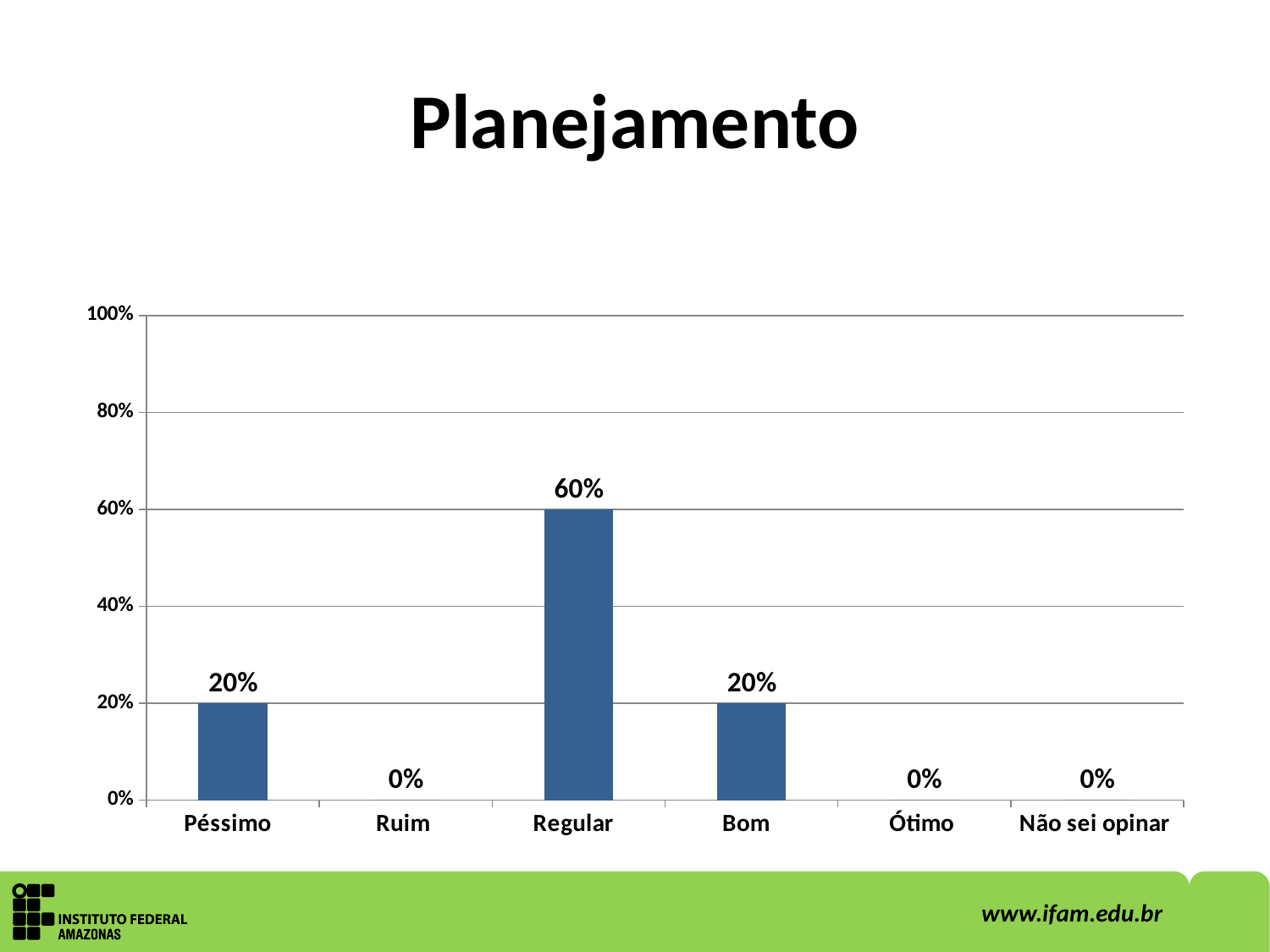
What is the value for Ótimo? 0% Is the value for Regular greater or less than 40%? greater What is the difference between the values for Regular and Bom? 40% What is the highest value shown on the y axis? 100% Which category has the highest value? Regular What kind of chart is shown on the slide? bar chart What is the value for Péssimo? 20% Which is larger, the value for Regular or the value for Péssimo? Regular What is the title of the slide? Planejamento What is the value for Regular? 60% How many categories have a value of 0%? 3 How many categories are shown on the x axis? 6